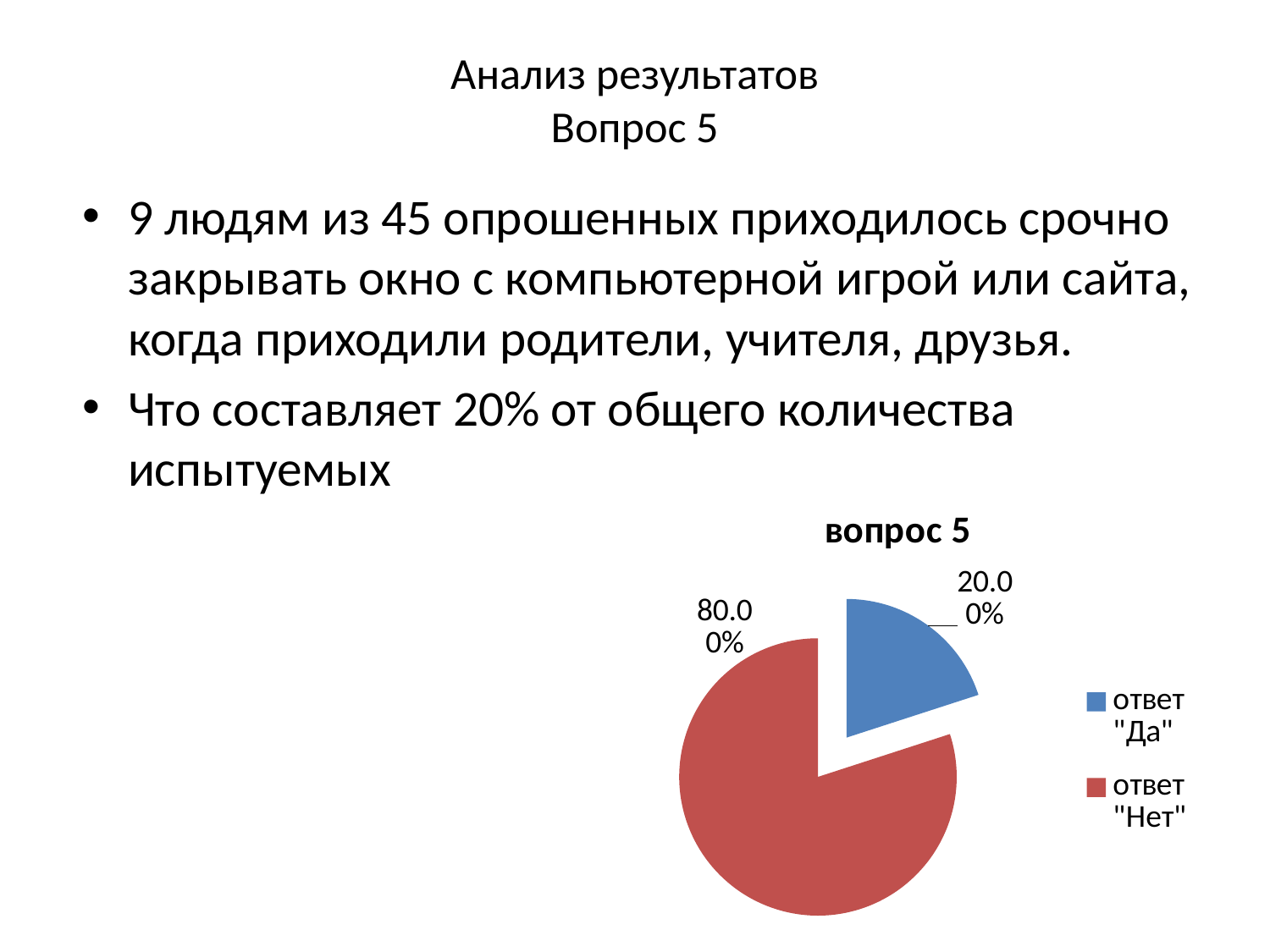
What is the title of the chart? вопрос 5 Which slice is the smallest? ответ "Да" What colour is the slice for ответ "Да"? blue What share of the pie is labelled for ответ "Да"? 20.00% How many slices does the pie chart have? 2 Which is larger, the slice for ответ "Да" or the slice for ответ "Нет"? ответ "Нет" What kind of chart is shown on the slide? pie chart Which slice is the largest? ответ "Нет" How many entries does the legend list? 2 What share of the pie is labelled for ответ "Нет"? 80.00% Is the share for ответ "Нет" greater or less than 50%? greater What is the difference in percentage points between the ответ "Нет" slice and the ответ "Да" slice? 60.00%